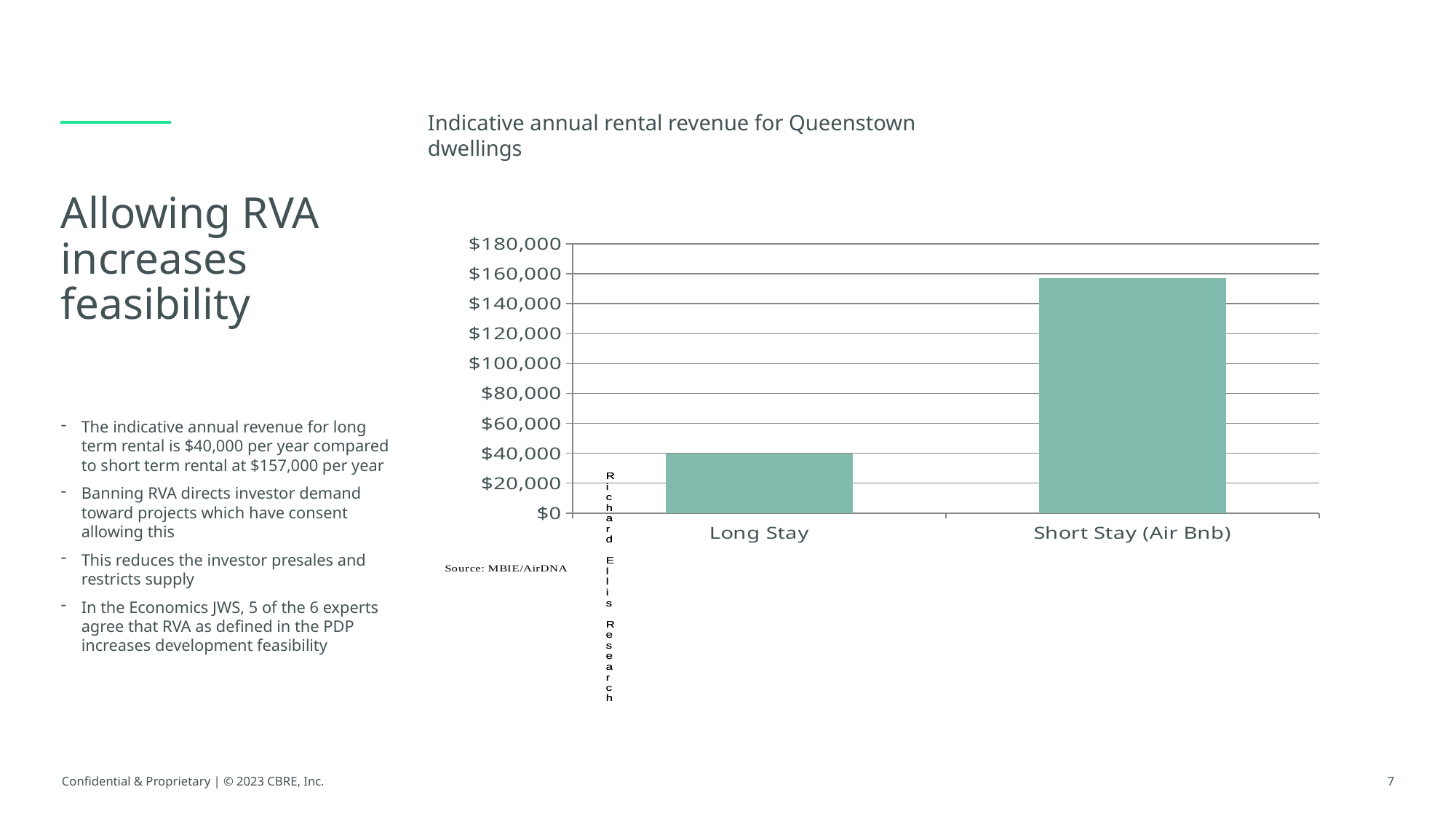
What type of chart is shown on the slide? bar chart What is the indicative annual rental revenue for Long Stay in the chart? $40,000 What source is cited below the chart? MBIE/AirDNA How many categories are plotted in the chart? 2 Is the value for Long Stay greater or less than $60,000? less What is the title of the chart? Indicative annual rental revenue for Queenstown dwellings Which category has the lowest value in the chart? Long Stay Is the value for Short Stay (Air Bnb) greater or less than $140,000? greater Which category has the highest value in the chart? Short Stay (Air Bnb) What is the highest value shown on the chart's vertical axis? $180,000 Is the value for Short Stay (Air Bnb) greater or less than $160,000? less Which is larger, the value for Long Stay or the value for Short Stay (Air Bnb)? Short Stay (Air Bnb)